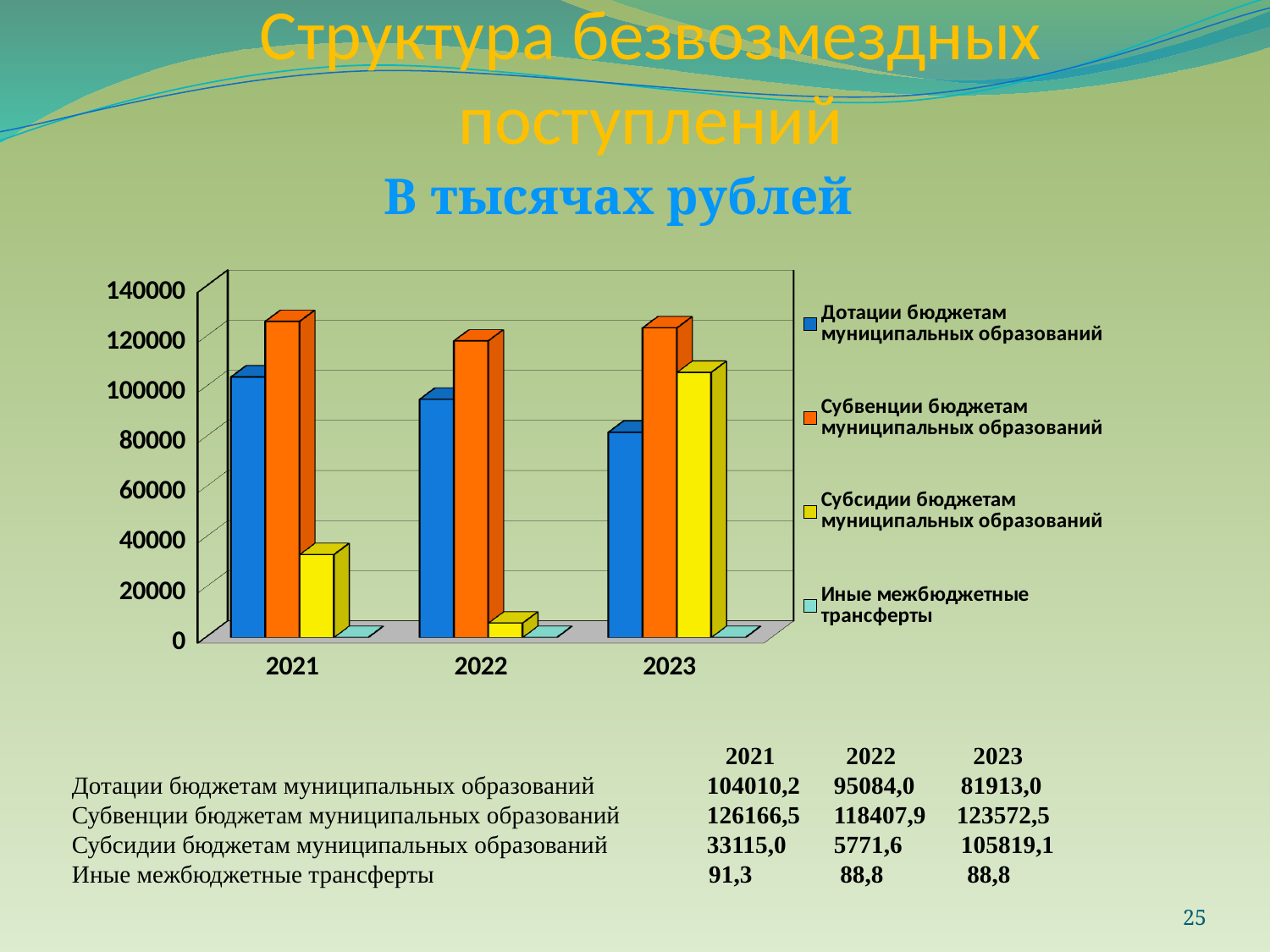
In 2023, which is larger: Субвенции бюджетам муниципальных образований or Субсидии бюджетам муниципальных образований? Субвенции бюджетам муниципальных образований What is the difference between Дотации бюджетам муниципальных образований in 2021 and in 2022? 8926,2 What is the value of Субсидии бюджетам муниципальных образований in 2022? 5771,6 What is the value of Субвенции бюджетам муниципальных образований in 2021? 126166,5 Do the values for Дотации бюджетам муниципальных образований rise or fall from 2021 to 2023? fall Is the value for Субсидии бюджетам муниципальных образований in 2023 greater or less than 100000? greater In which year is Субвенции бюджетам муниципальных образований highest? 2021 What kind of chart is shown on the slide? bar chart How many series does the chart legend list? 4 How many years are shown on the x axis of the chart? 3 In which year is Дотации бюджетам муниципальных образований lowest? 2023 What colour represents Субсидии бюджетам муниципальных образований in the chart? yellow